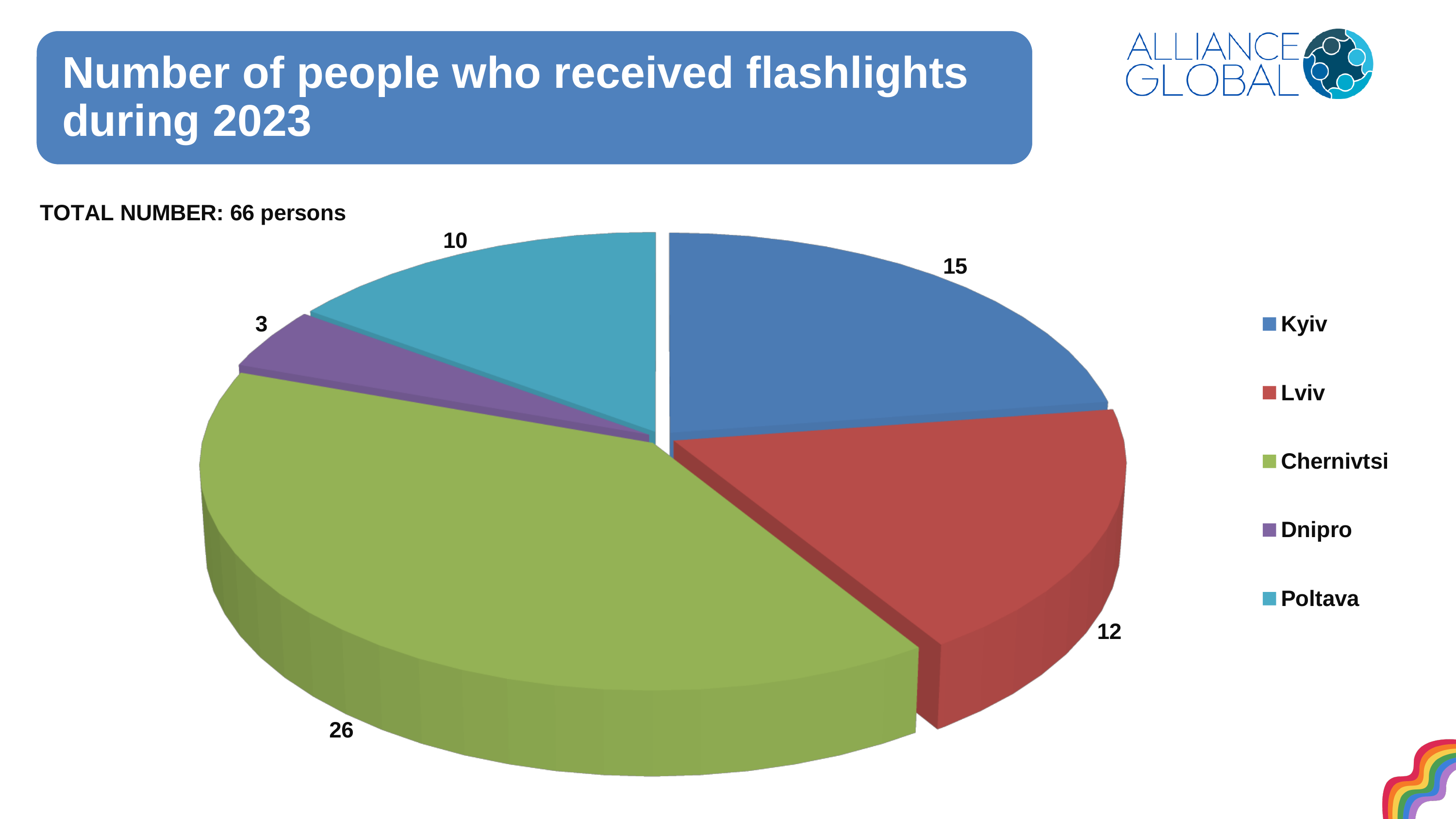
How many people in Poltava received flashlights during 2023? 10 How many people in Dnipro received flashlights during 2023? 3 How many people in Chernivtsi received flashlights during 2023? 26 How many people in Kyiv received flashlights during 2023? 15 Which city had more people receive flashlights, Kyiv or Poltava? Kyiv How many cities are shown in the pie chart? 5 Which city has the largest number of people who received flashlights? Chernivtsi Which city has the smallest number of people who received flashlights? Dnipro What is the difference between the number of people who received flashlights in Chernivtsi and in Lviv? 14 What type of chart is shown on the slide? Pie chart What is the total number of persons stated on the slide? 66 persons What colour represents Lviv in the pie chart? Red